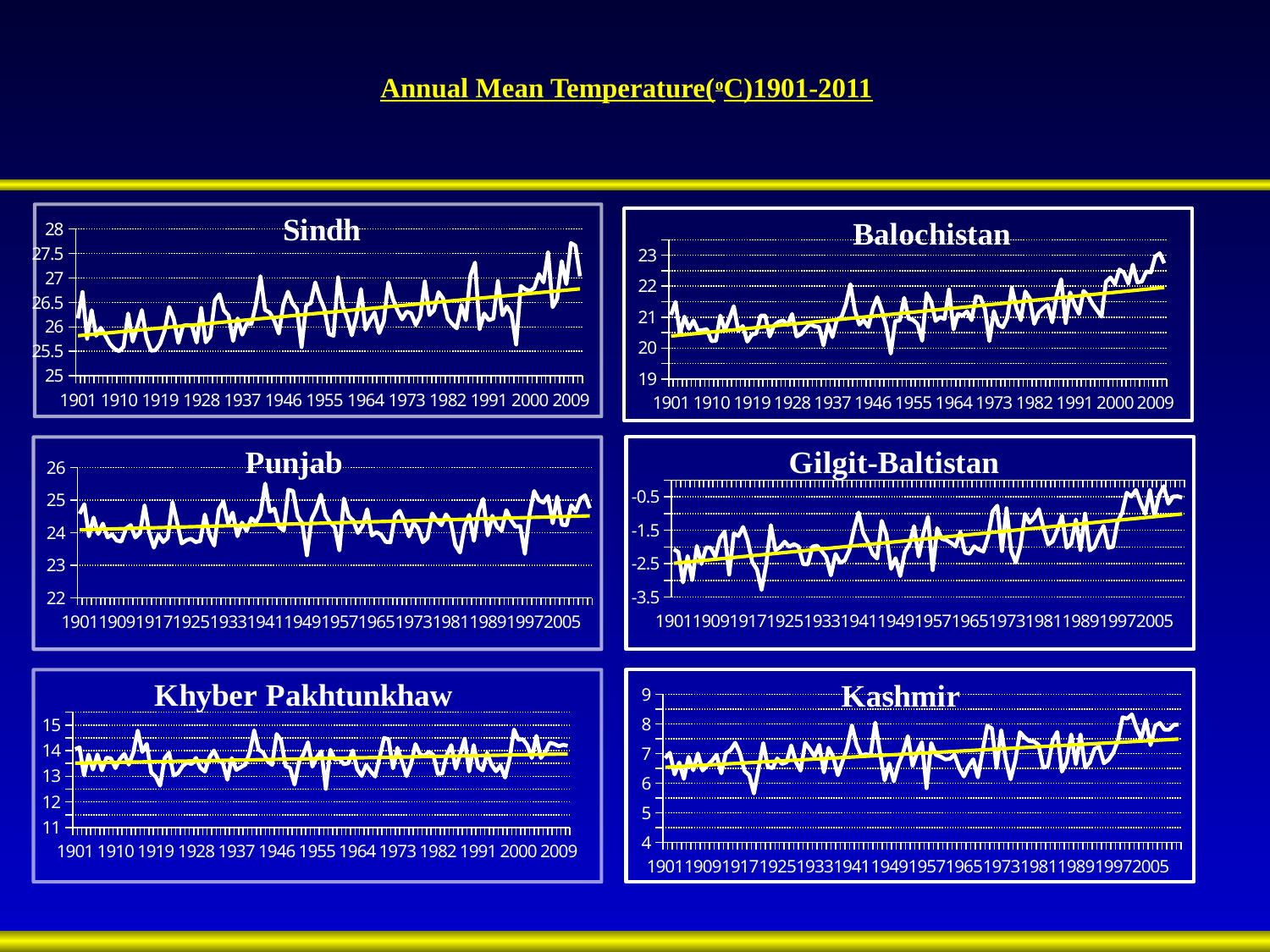
What is the highest value shown on the y axis of the Sindh chart? 28 In the Khyber Pakhtunkhaw chart, is the value for 1901 greater or less than 12? greater How many charts are shown on the slide? 6 In the Punjab chart, is the value for 1901 greater or less than 23? greater In the Gilgit-Baltistan chart, does the trend line rise or fall over the period shown? rise What is the title of the slide? Annual Mean Temperature(°C)1901-2011 In the Balochistan chart, is the value for 2009 greater or less than 21? greater In the Sindh chart, does the trend line rise or fall from 1901 to 2009? rise What kind of chart is the Sindh chart? line chart In the Balochistan chart, does the trend line rise or fall over the period shown? rise